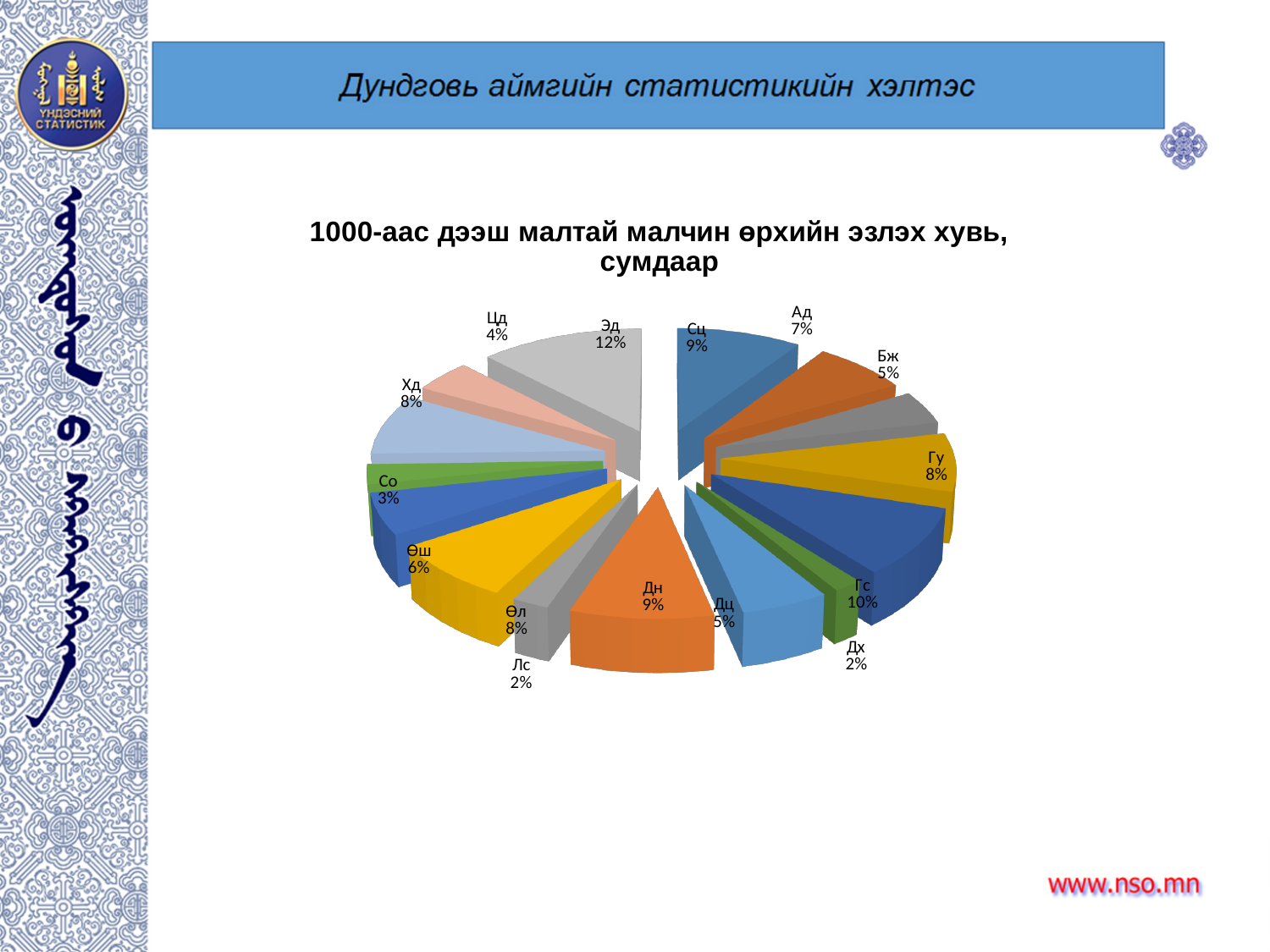
What kind of chart is shown on the slide? pie chart Which is larger, the share for Хд or the share for Дц? Хд What is the difference between the shares of Эд and Цд? 8% What is the difference between the shares of Гс and Дх? 8% Which slice has the largest share of the pie? Эд How many slices does the pie chart have? 15 What is the value shown for Гс? 10% What percentage is shown for Өш? 6% What share of the pie does Эд have? 12% What is the title of the chart? 1000-аас дээш малтай малчин өрхийн эзлэх хувь, сумдаар What is the value shown for Со? 3% Which is larger, the share for Сц or the share for Бж? Сц